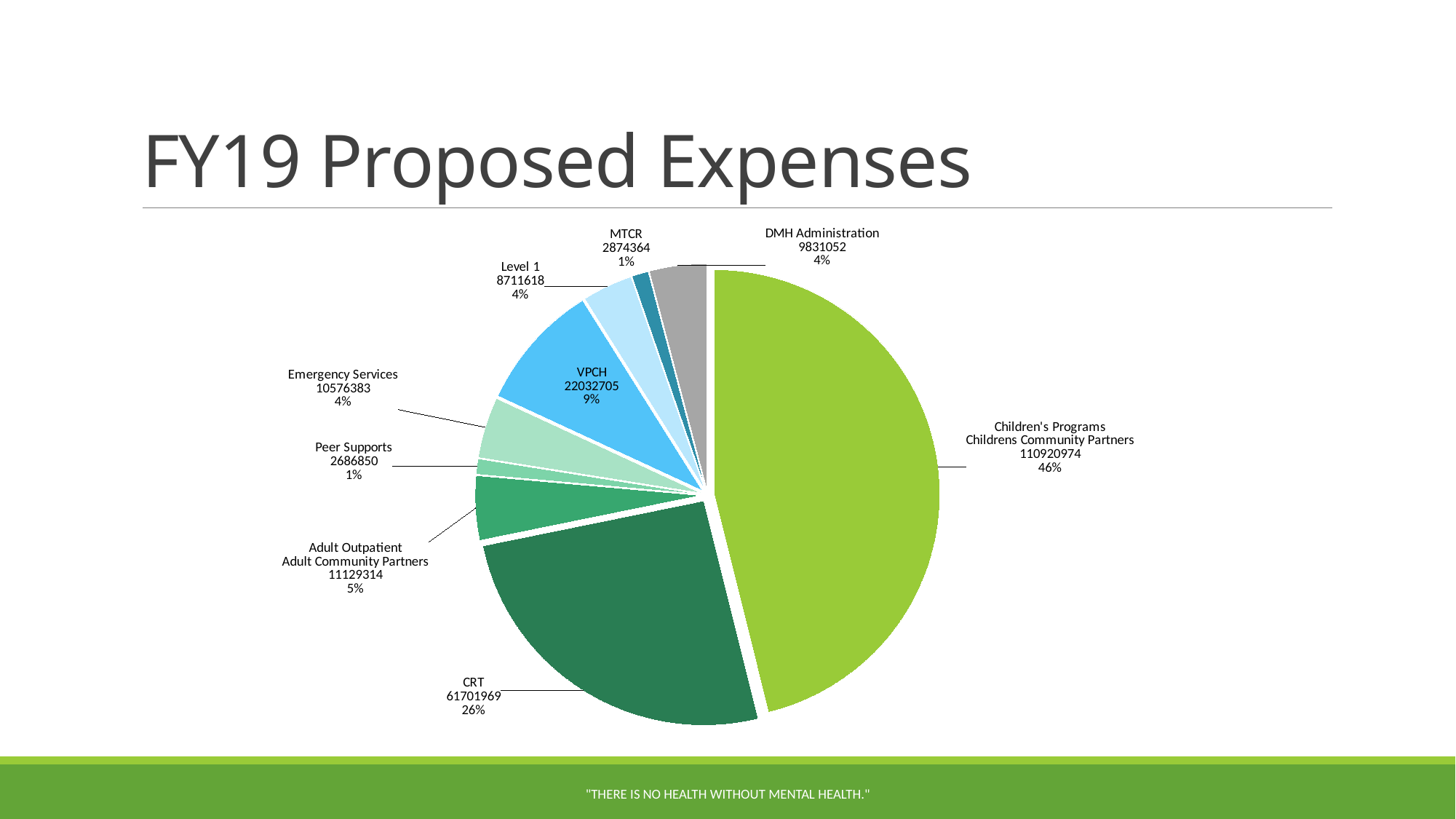
What type of chart is shown on the slide? Pie chart What is the value for VPCH? 22032705 What is the value for Emergency Services? 10576383 Which category has the largest slice? Children's Programs Childrens Community Partners What share of the pie does Adult Outpatient Adult Community Partners represent? 5% What is the value for CRT? 61701969 What is the difference between the values for CRT and VPCH? 39669264 What share of the pie does Children's Programs Childrens Community Partners represent? 46% What is the title of the slide's chart? FY19 Proposed Expenses How many slices does the pie chart have? 9 Which is larger, Adult Outpatient Adult Community Partners or DMH Administration? Adult Outpatient Adult Community Partners What is the difference between the values for MTCR and Peer Supports? 187514